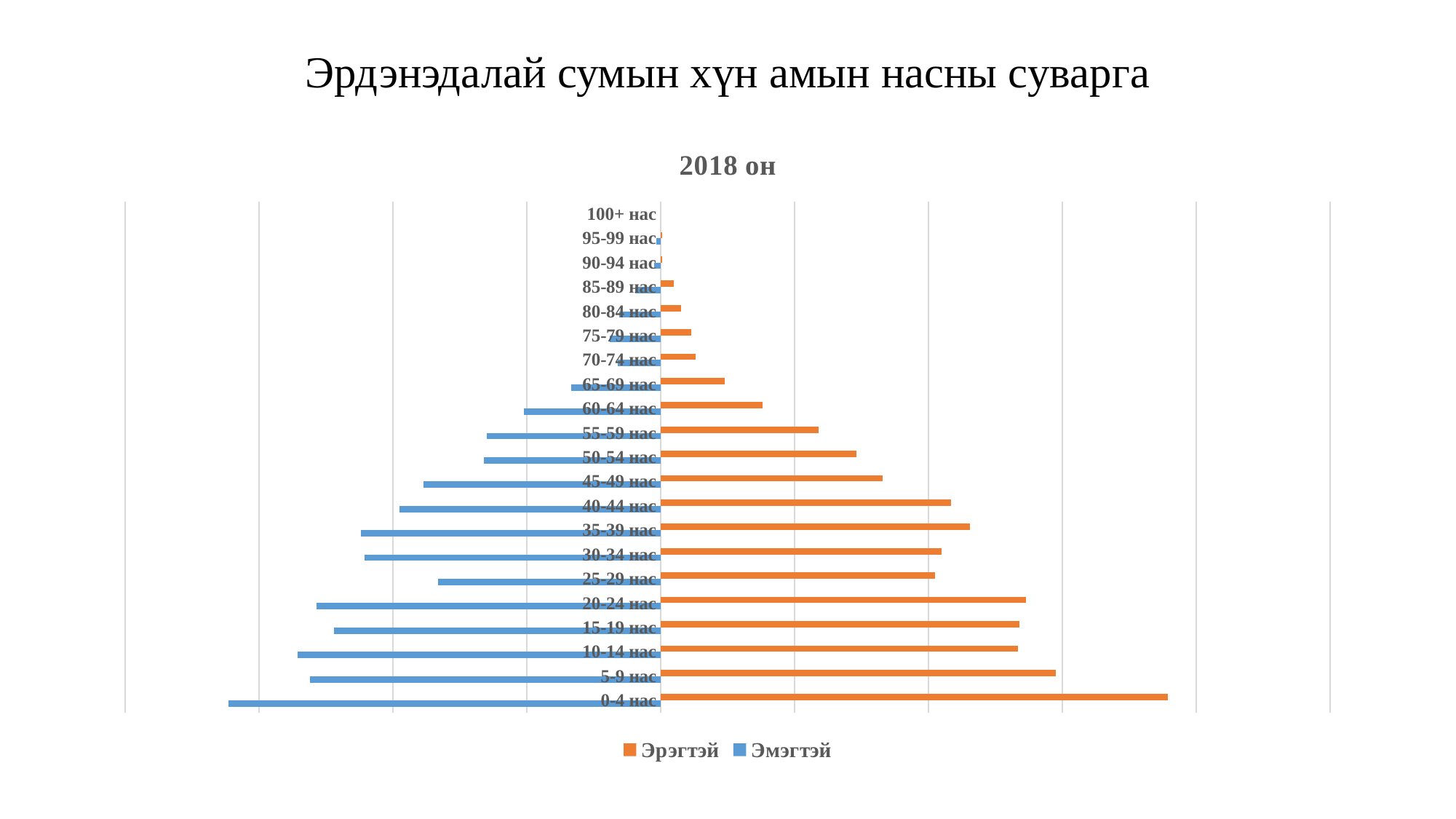
What kind of chart is shown on the slide? Bar chart Do the values generally rise or fall as the age groups get older? Fall What year is shown in the chart's subtitle? 2018 он Which colour represents the Эмэгтэй series? Blue Which age group has the highest value for the Эрэгтэй series? 0-4 нас Which age group has the highest value for the Эмэгтэй series? 0-4 нас For the Эмэгтэй series, which is larger: the value for 25-29 нас or for 30-34 нас? 30-34 нас How many series does the legend list? 2 How many age-group categories are plotted on the chart? 21 For the Эрэгтэй series, which is larger: the value for 55-59 нас or for 65-69 нас? 55-59 нас For the Эрэгтэй series, which is larger: the value for 0-4 нас or for 5-9 нас? 0-4 нас